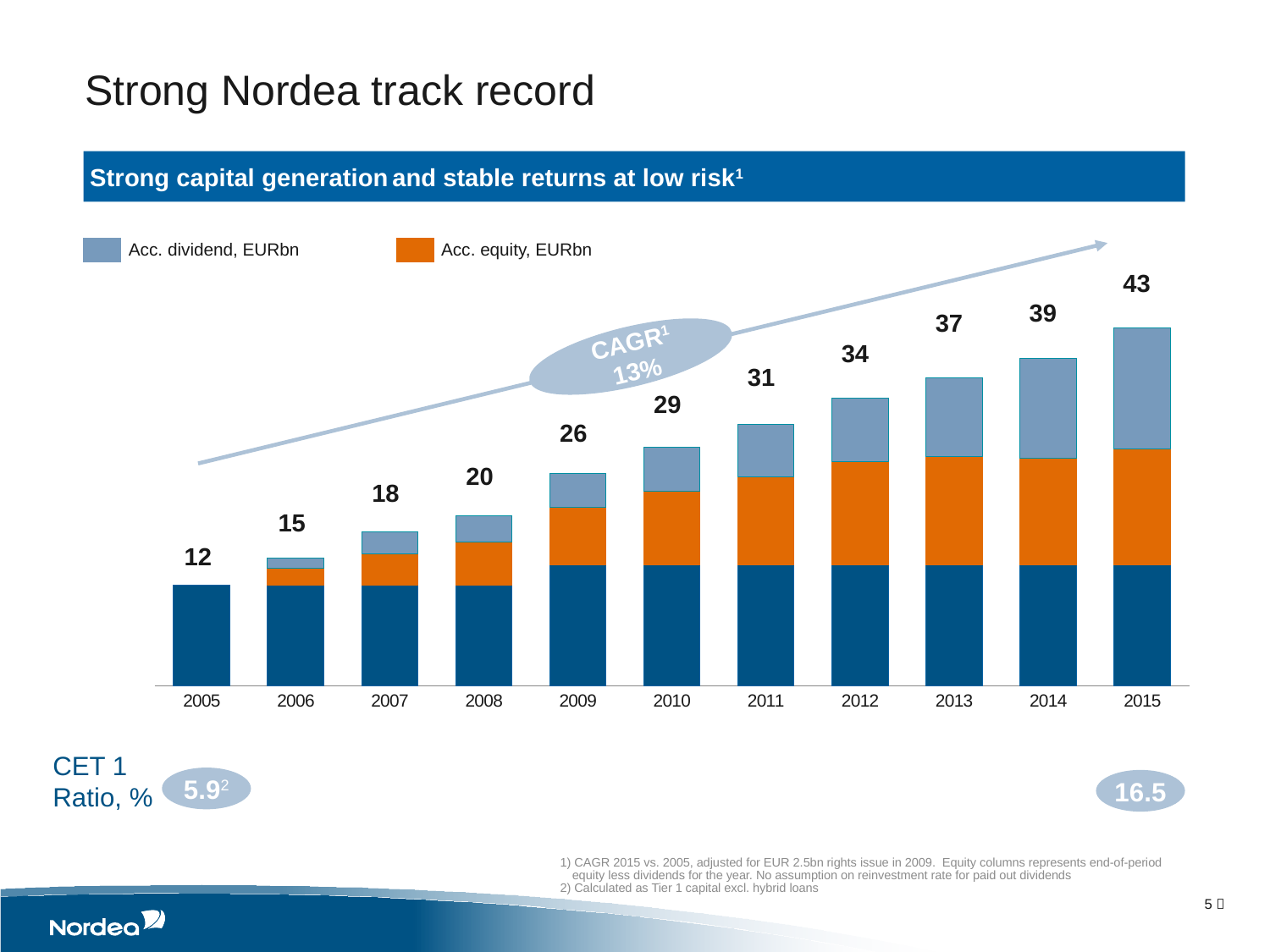
Which year has a larger total, 2011 or 2013? 2013 How many series does the legend list? 2 What is the difference between the total for 2015 and the total for 2005? 31 What is the difference between the total for 2009 and the total for 2008? 6 Which year has the highest total value? 2015 What kind of chart is shown on the slide? Stacked bar chart What is the total value shown above the bar for 2012? 34 Do the total values rise or fall from 2005 to 2015? Rise Which year has the lowest total value? 2005 How many years are shown on the x axis of the chart? 11 What is the total value shown above the bar for 2009? 26 What is the total value shown above the bar for 2015? 43